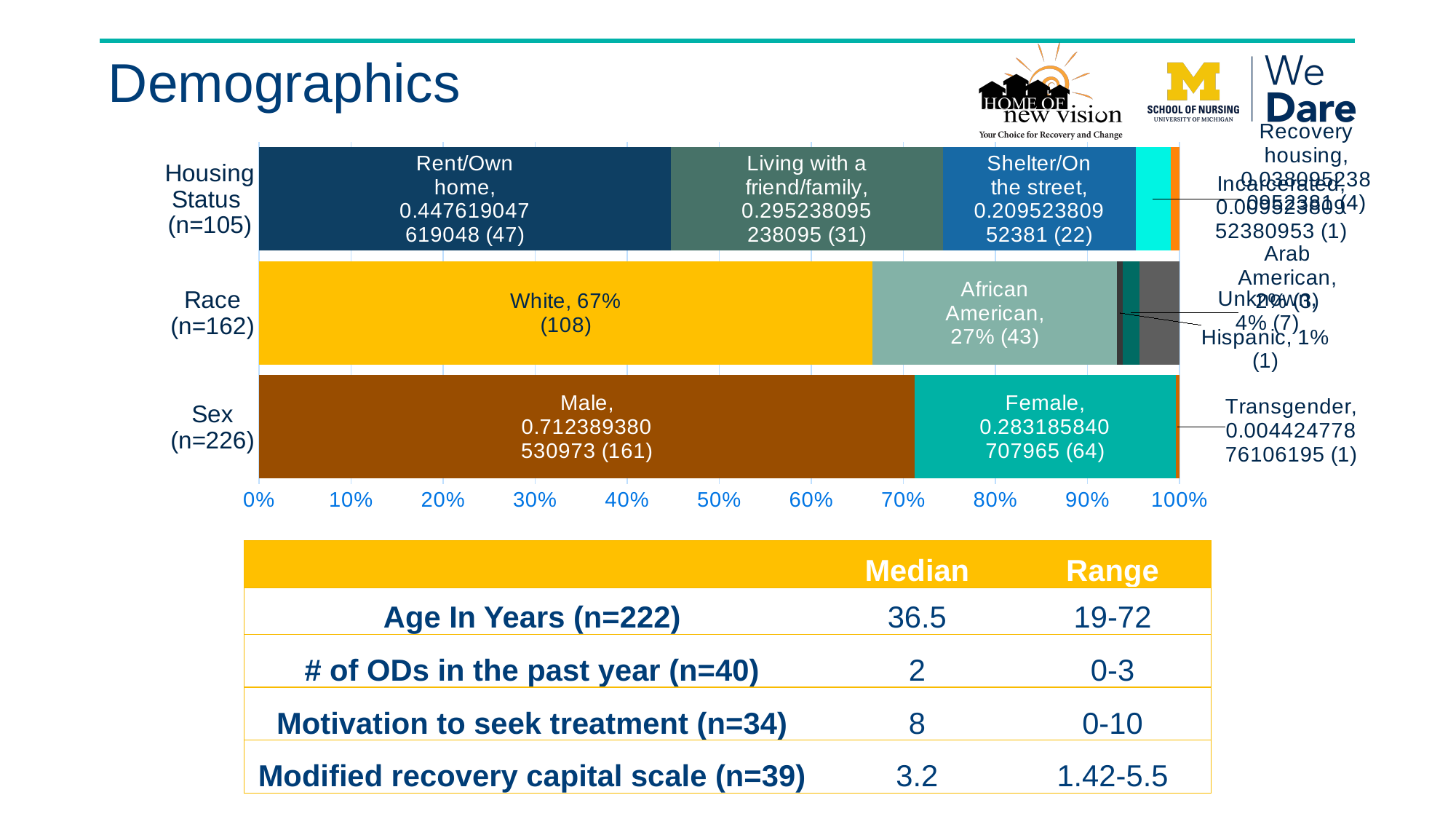
How many categories are shown on the vertical axis of the chart? 3 Which segment is the largest in the Housing Status bar? Rent/Own home What is the difference between the Male count and the Female count in the Sex bar? 97 What percentage of the Race bar is labelled Unknown? 4% Is the share of the Race bar labelled White greater or less than 60%? greater How many respondents are labelled as Male in the Sex bar? 161 Which segment is the smallest in the Sex bar? Transgender In the Housing Status bar, which has the larger count: Living with a friend/family or Shelter/On the street? Living with a friend/family What percentage of the Race bar is labelled White? 67% How many respondents are labelled African American in the Race bar? 43 What is the difference between the White count and the African American count in the Race bar? 65 What kind of chart is shown on the slide? Stacked bar chart